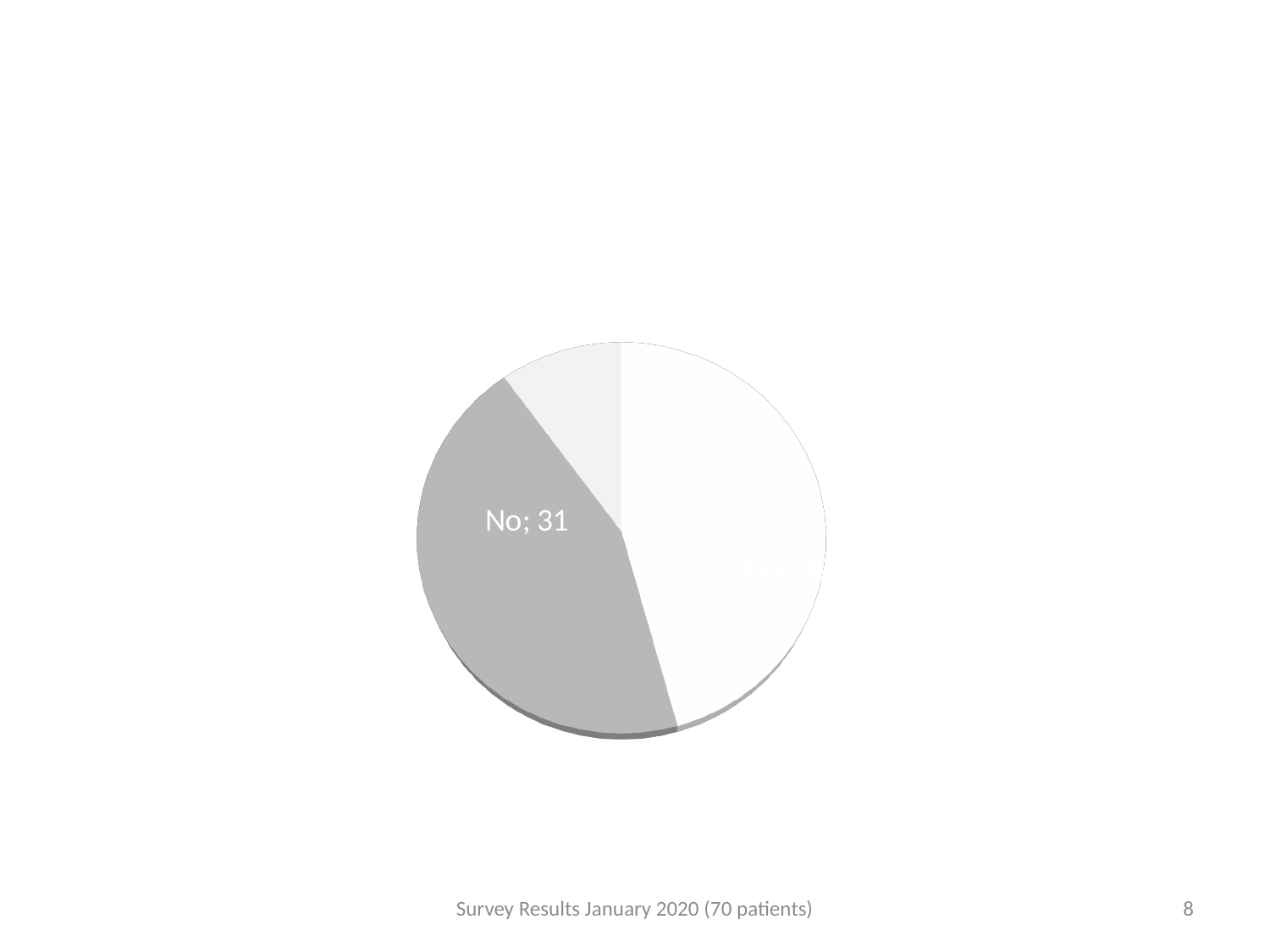
How many slices does the pie chart have? 3 How many slices of the pie chart have a data label printed on them? 1 What kind of chart is shown on the slide? pie chart What value is shown for the "No" slice of the pie chart? 31 What is the only data label printed on the pie chart? No; 31